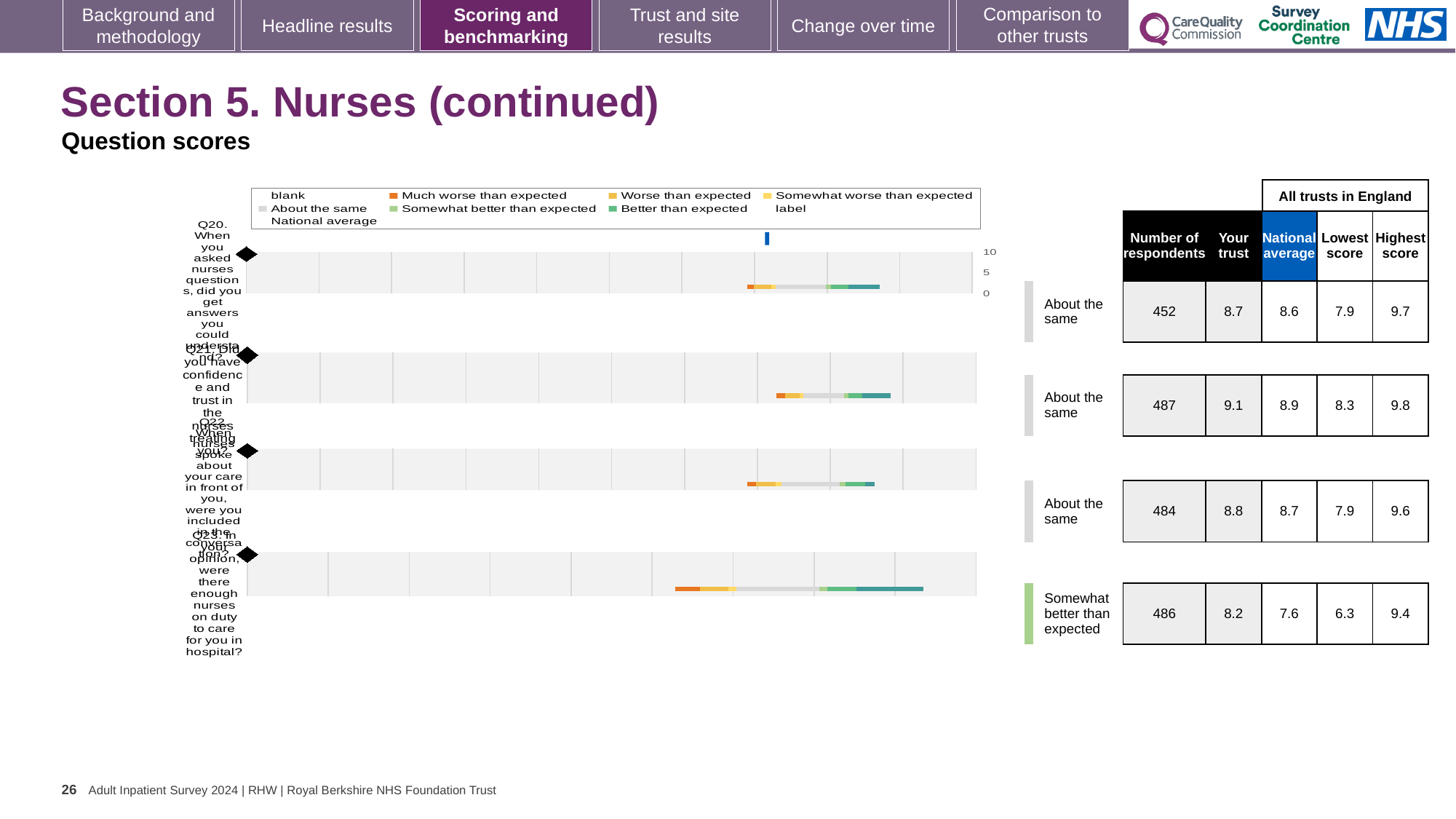
What is the difference between the highest score and the lowest score across all trusts for Q23? 3.1 What is the difference between the 'Your trust' score and the national average for Q23? 0.6 What is the 'Your trust' score for Q21 (confidence and trust in nurses)? 9.1 What kind of chart is shown on the slide? bar chart Which legend entry is shown in dark orange? Much worse than expected Which question has the lowest 'Your trust' score? Q23 Is the 'Your trust' score for Q20 higher or lower than the national average for Q20? higher How many respondents answered Q22? 484 How many survey questions (rows) are plotted in the chart? 4 What is the national average score for Q23 (enough nurses on duty)? 7.6 Which question has the highest 'Your trust' score? Q21 What is the highest value shown on the chart's score axis? 10